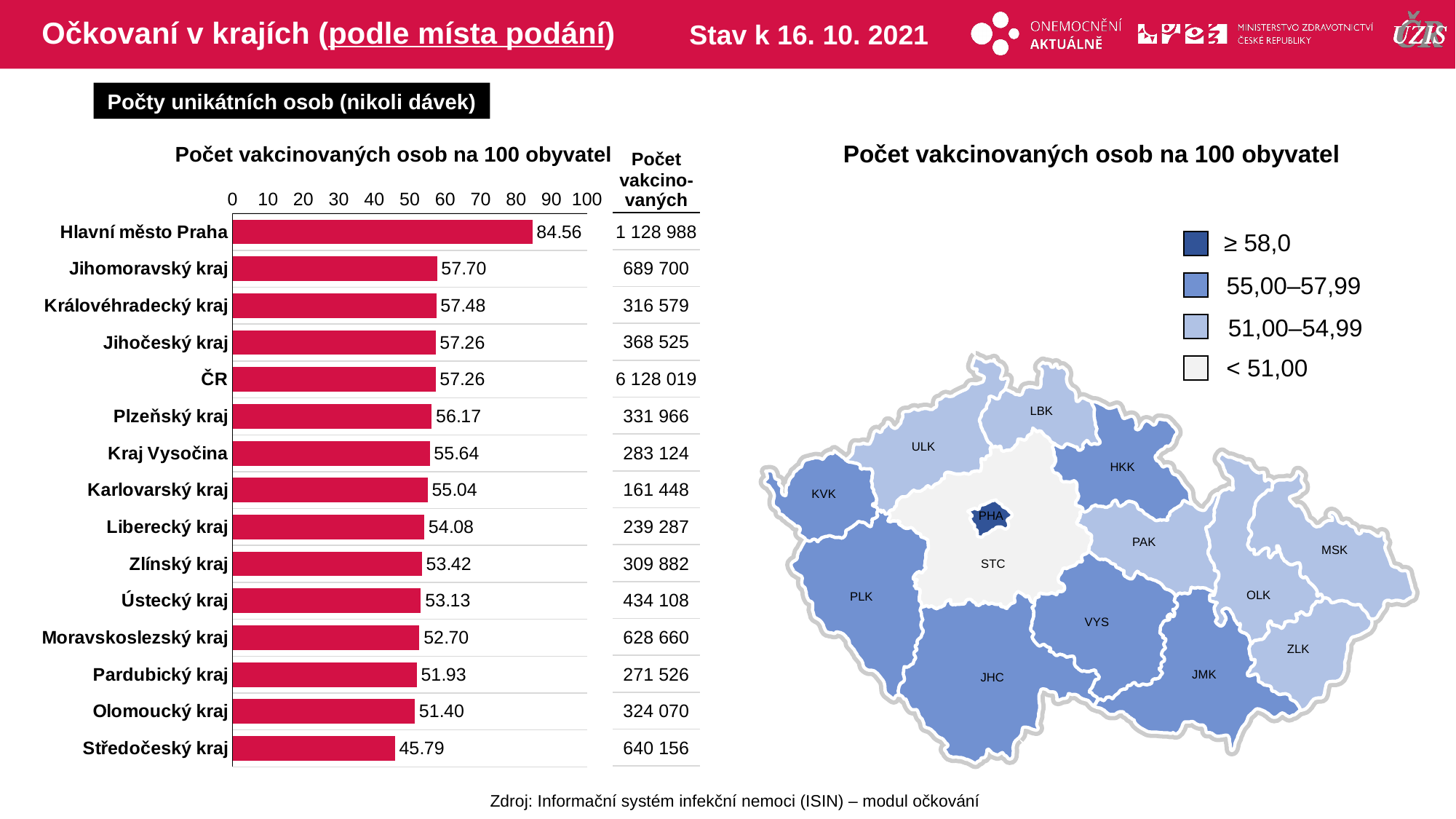
What is the maximum value shown on the horizontal axis of the bar chart 'Počet vakcinovaných osob na 100 obyvatel'? 100 In the bar chart 'Počet vakcinovaných osob na 100 obyvatel', what is the difference between the values for Jihomoravský kraj and Královéhradecký kraj? 0.22 In the bar chart 'Počet vakcinovaných osob na 100 obyvatel', what is the value for Hlavní město Praha? 84.56 In the bar chart 'Počet vakcinovaných osob na 100 obyvatel', which region has the highest value? Hlavní město Praha In the bar chart 'Počet vakcinovaných osob na 100 obyvatel', which region has the lowest value? Středočeský kraj In the bar chart 'Počet vakcinovaných osob na 100 obyvatel', what is the value for ČR? 57.26 In the bar chart 'Počet vakcinovaných osob na 100 obyvatel', what is the value for Karlovarský kraj? 55.04 In the bar chart 'Počet vakcinovaných osob na 100 obyvatel', what is the difference between the values for Hlavní město Praha and Středočeský kraj? 38.77 How many bars are shown in the bar chart 'Počet vakcinovaných osob na 100 obyvatel'? 15 In the bar chart 'Počet vakcinovaných osob na 100 obyvatel', which is larger: the value for Plzeňský kraj or the value for Olomoucký kraj? Plzeňský kraj In the bar chart 'Počet vakcinovaných osob na 100 obyvatel', is the value for Středočeský kraj greater or less than 50? less What type of chart is used on the left side of the slide to show 'Počet vakcinovaných osob na 100 obyvatel'? bar chart